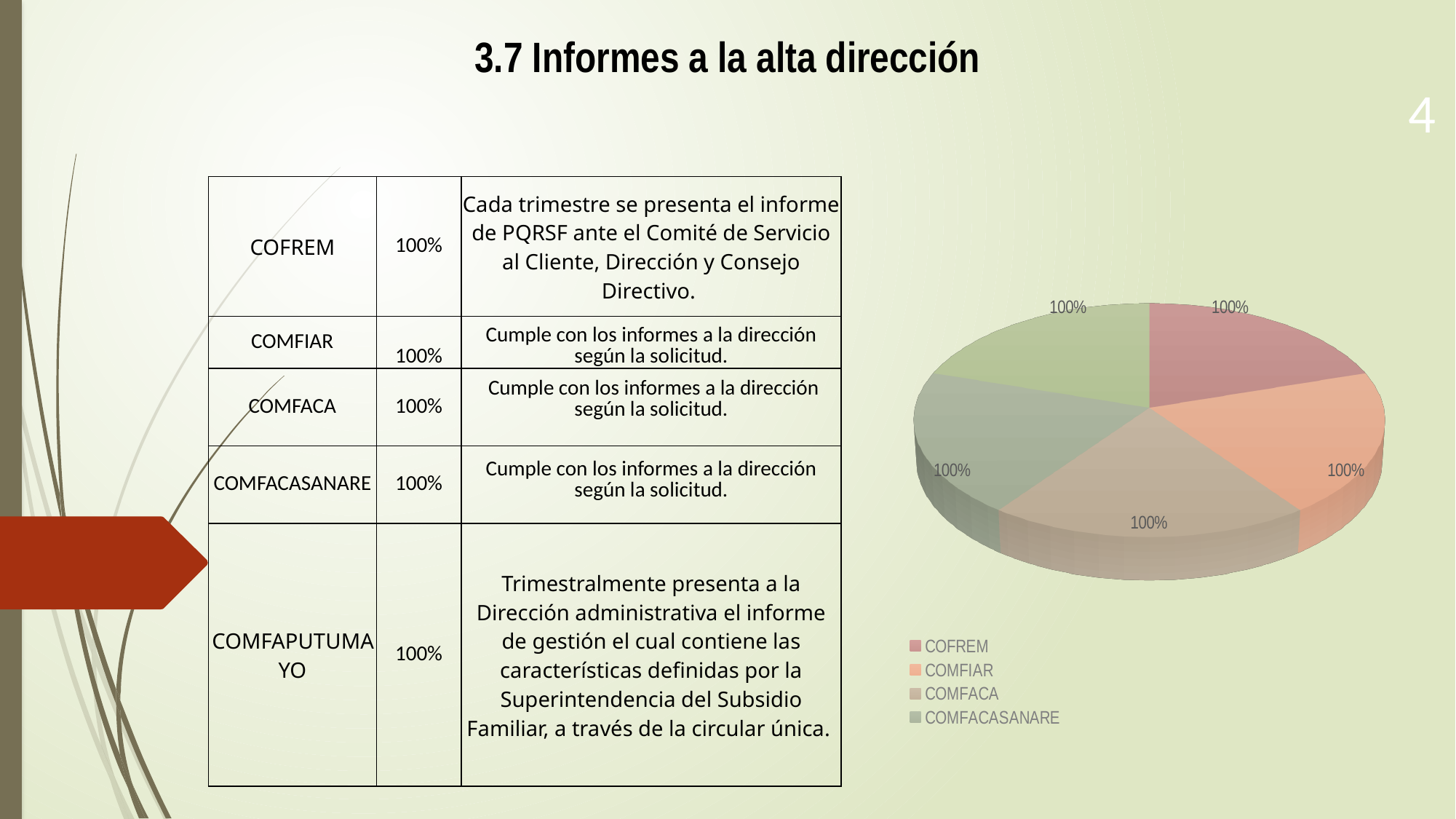
What value is labelled on the COMFIAR slice of the pie chart? 100% What value is labelled on the COMFACA slice of the pie chart? 100% What value is labelled on the COFREM slice of the pie chart? 100% What kind of chart is shown on the slide? pie chart What colour is the COFREM slice in the pie chart? red How many entries does the legend of the pie chart list? 4 Which entry appears first in the legend of the pie chart? COFREM What value is labelled on the COMFACASANARE slice of the pie chart? 100% How many slices does the pie chart have? 5